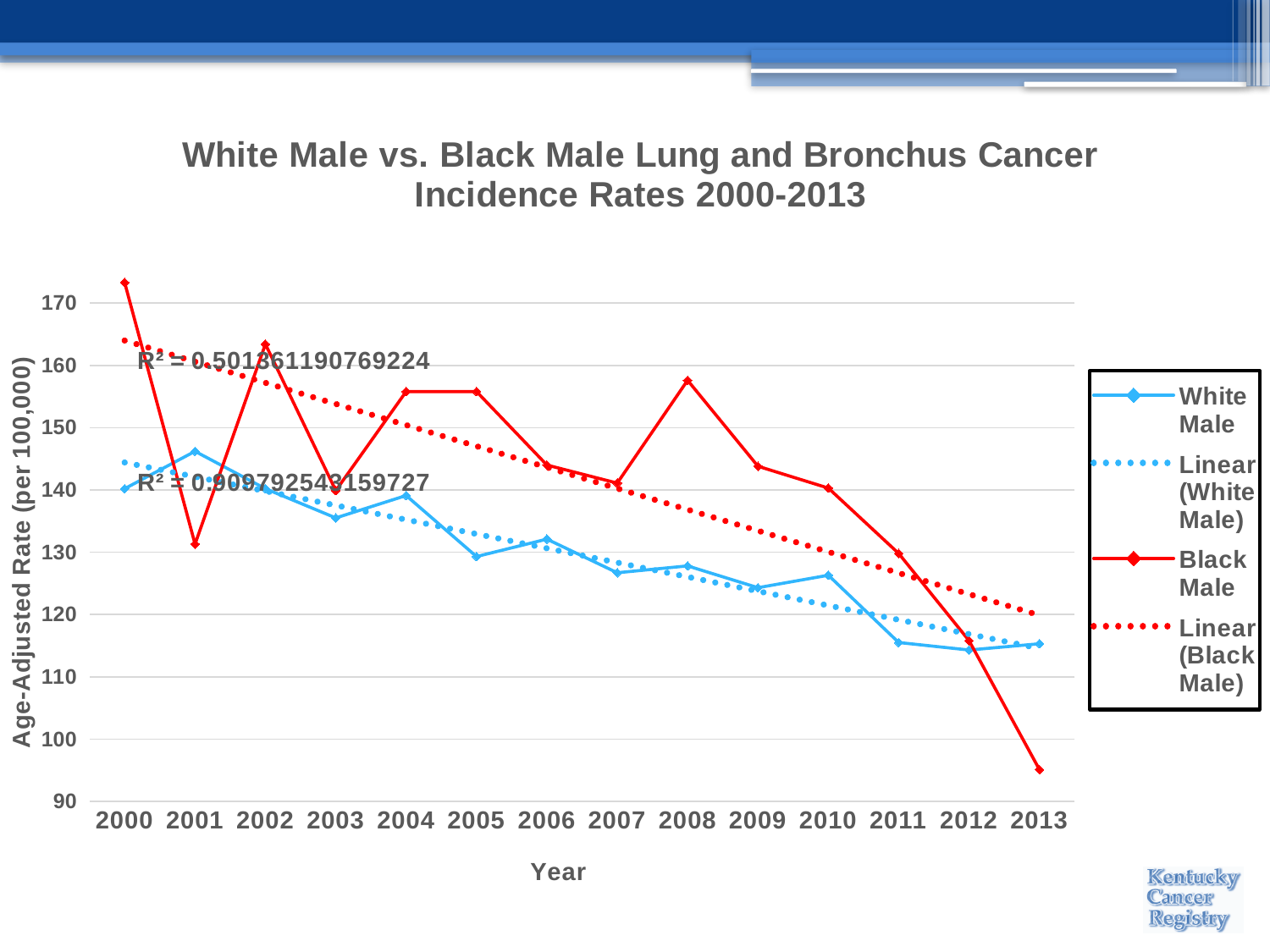
In which year is the Black Male incidence rate lowest? 2013 What is the title of the vertical axis? Age-Adjusted Rate (per 100,000) How many years are plotted along the x axis? 14 Does the White Male incidence rate generally rise or fall from 2000 to 2013? Fall Is the Black Male value for 2000 greater or less than 170? greater Is the Black Male value for 2013 greater or less than 100? less What kind of chart is shown on the slide? Line chart In which year is the Black Male incidence rate highest? 2000 How many entries does the legend list? 4 Is the White Male value for 2013 greater or less than 120? less In 2001, which series has the larger value, White Male or Black Male? White Male In which year is the White Male incidence rate highest? 2001